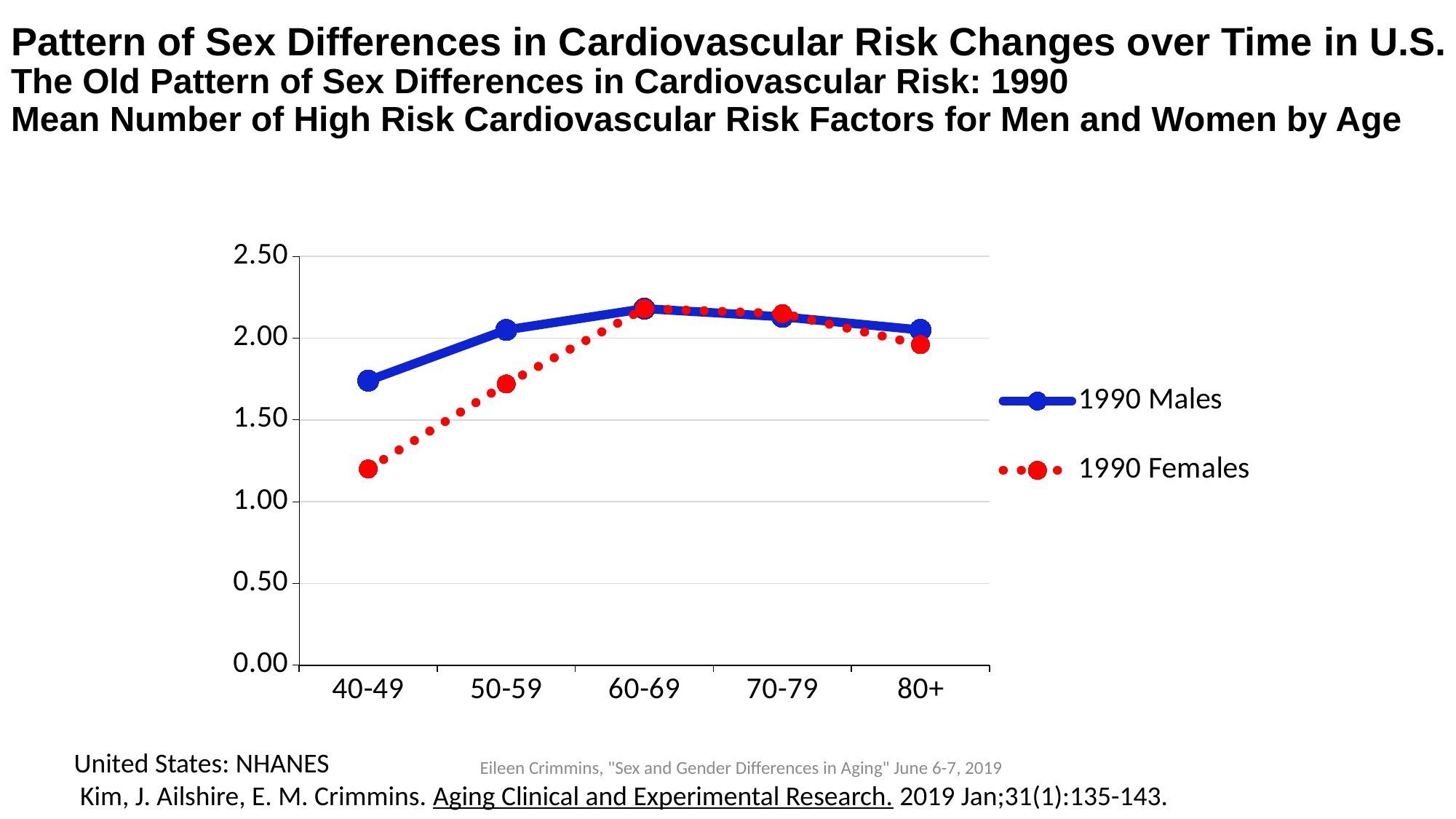
Is the value for 1990 Females in the 50-59 age group greater or less than 2.00? less What kind of chart is shown on the slide? line chart Do the values for 1990 Females rise or fall from the 40-49 age group to the 60-69 age group? rise How many age groups are shown on the x axis? 5 Which age group has the lowest value for 1990 Males? 40-49 In the 40-49 age group, which series has the larger value, 1990 Males or 1990 Females? 1990 Males Is the value for 1990 Males in the 60-69 age group greater or less than 2.00? greater Is the value for 1990 Females in the 40-49 age group greater or less than 1.50? less Which series is drawn with a dotted red line? 1990 Females How many series does the legend list? 2 Which age group has the lowest value for 1990 Females? 40-49